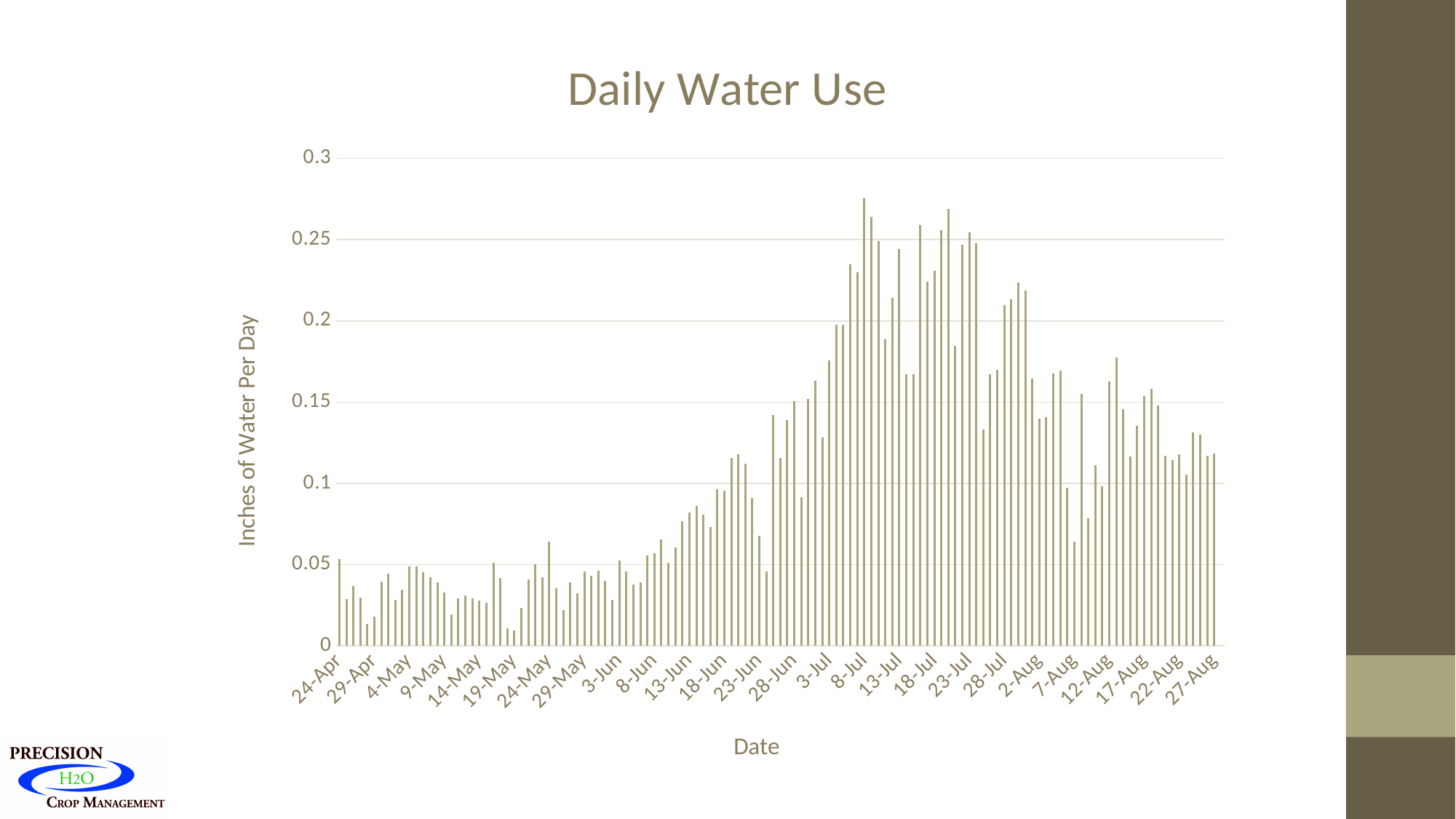
Do the values generally rise or fall from 24-Apr to 8-Jul? rise Are the daily water use values in mid-July higher or lower than those in early May? higher What is the label on the vertical axis of the chart? Inches of Water Per Day Is the lowest value on the chart greater or less than 0.05? less What kind of chart is shown on the slide? bar chart Is the value for the last date, 27-Aug, greater or less than 0.1? greater Is the highest value on the chart greater or less than 0.3? less What is the title of the chart? Daily Water Use In which month does the highest daily water use value occur? July Do the values generally rise or fall from 13-Jul to 27-Aug? fall